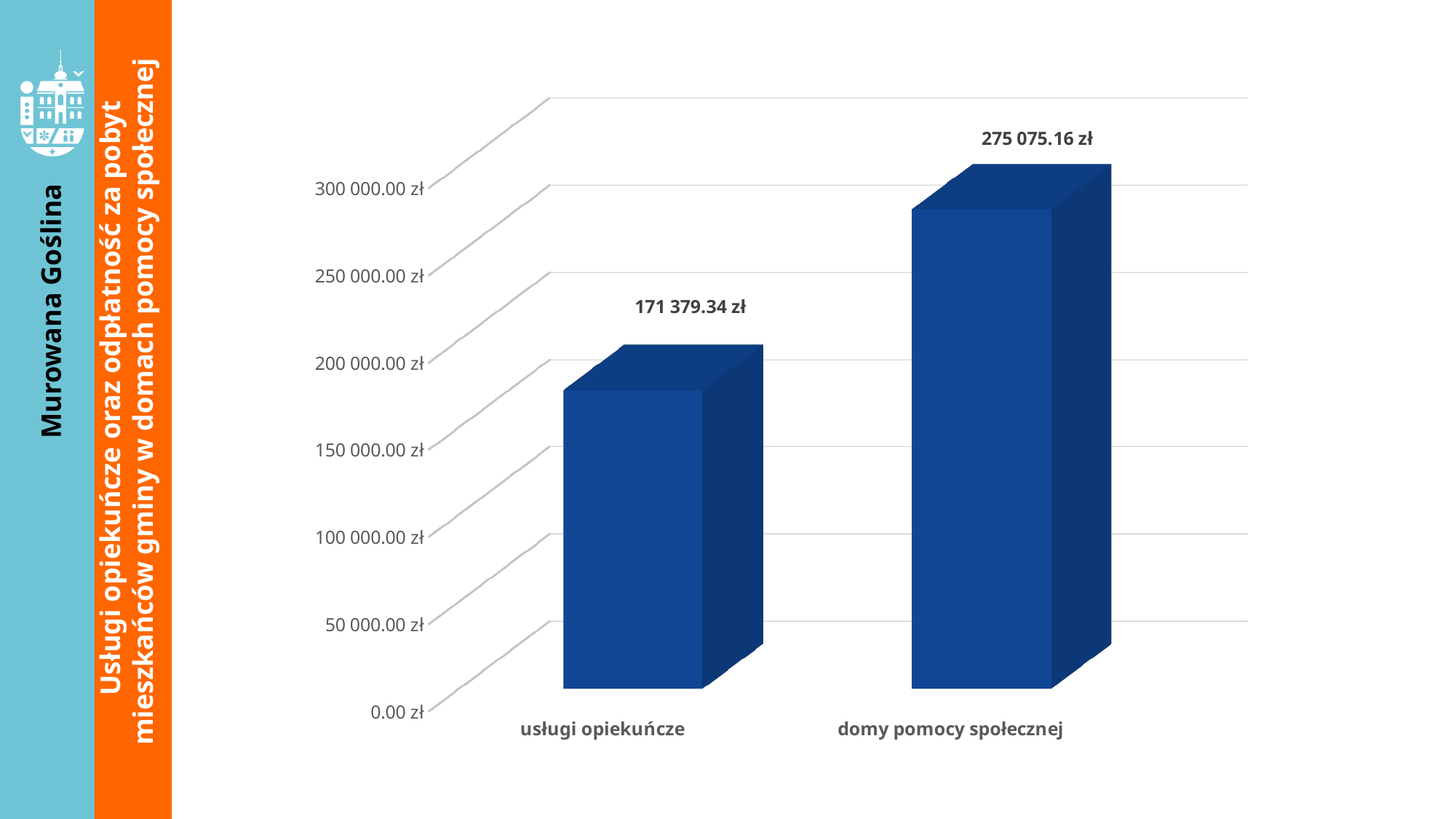
Is the value for domy pomocy społecznej greater or less than 250 000.00 zł? greater What is the value for usługi opiekuńcze? 171 379.34 zł What is the combined total of the two bars on the chart? 446 454.50 zł What is the value for domy pomocy społecznej? 275 075.16 zł Which is larger, the value for usługi opiekuńcze or the value for domy pomocy społecznej? domy pomocy społecznej What is the difference between the values for domy pomocy społecznej and usługi opiekuńcze? 103 695.82 zł What is the title of the slide containing the chart? Usługi opiekuńcze oraz odpłatność za pobyt mieszkańców gminy w domach pomocy społecznej Which category has the lowest value? usługi opiekuńcze Which category has the highest value? domy pomocy społecznej How many categories are shown on the chart? 2 What kind of chart is shown on the slide? bar chart Is the value for usługi opiekuńcze greater or less than 200 000.00 zł? less